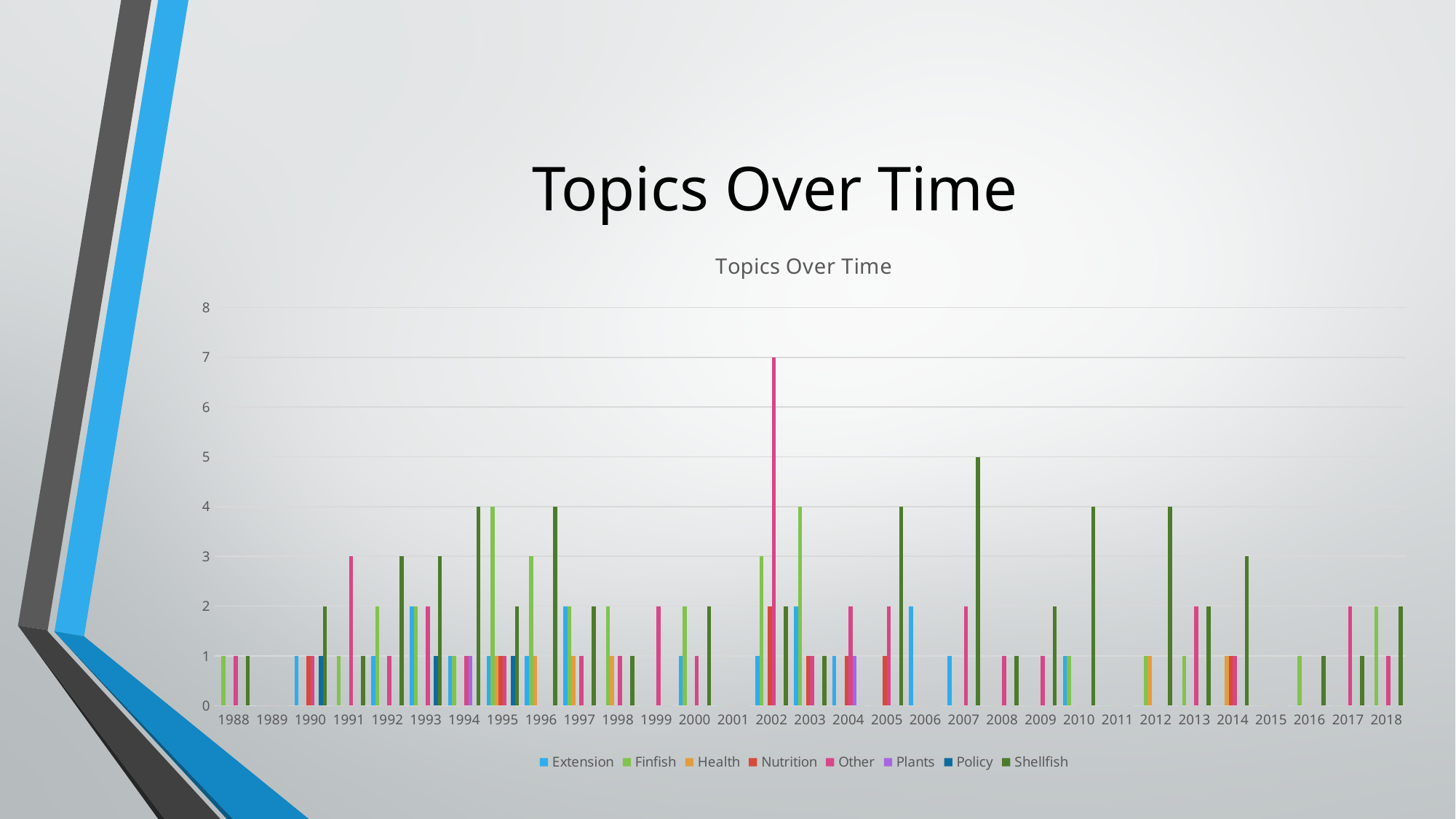
In which year does the tallest bar on the chart appear? 2002 Which is larger, the Shellfish value in 2007 or the Shellfish value in 2010? 2007 What is the value for Shellfish in 2007? 5 What is the value for Other in 2002? 7 What is the value for Finfish in 2003? 4 What is the first entry listed in the legend? Extension Is the value for Other in 2002 greater or less than 6? greater How many series does the legend list? 8 What kind of chart is shown on the slide? bar chart What is the value for Other in 1991? 3 What is the difference between the Other value in 2002 and the Shellfish value in 2007? 2 How many years are shown along the x axis? 31